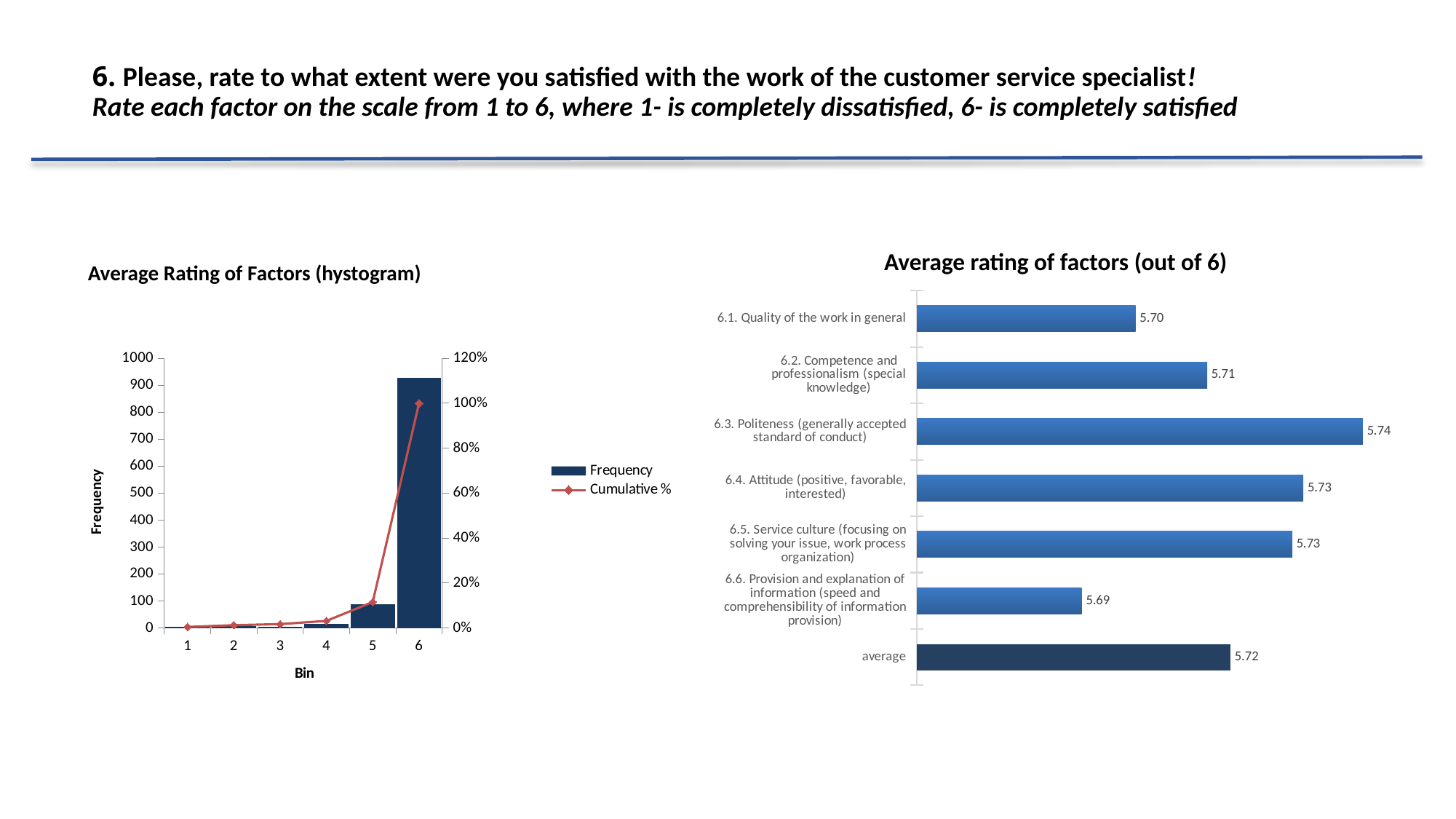
How many bars are shown in the 'Average rating of factors (out of 6)' chart? 7 In the 'Average rating of factors (out of 6)' chart, which factor has the highest rating? 6.3. Politeness (generally accepted standard of conduct) In the 'Average Rating of Factors (hystogram)' chart, what is the Cumulative % at bin 6? 100% In the 'Average Rating of Factors (hystogram)' chart, how many series does the legend list? 2 In the 'Average rating of factors (out of 6)' chart, what is the difference between the rating for 6.3. Politeness and the rating for 6.6. Provision and explanation of information? 0.05 In the 'Average rating of factors (out of 6)' chart, what is the value for 6.6. Provision and explanation of information? 5.69 What kind of chart is the 'Average rating of factors (out of 6)' chart? Bar chart In the 'Average Rating of Factors (hystogram)' chart, is the Frequency for bin 6 greater or less than 800? greater In the 'Average rating of factors (out of 6)' chart, which is larger: the rating for 6.1. Quality of the work in general or for 6.2. Competence and professionalism? 6.2. Competence and professionalism In the 'Average rating of factors (out of 6)' chart, what is the value for 'average'? 5.72 In the 'Average rating of factors (out of 6)' chart, what is the value for 6.3. Politeness (generally accepted standard of conduct)? 5.74 In the 'Average rating of factors (out of 6)' chart, which factor has the lowest rating? 6.6. Provision and explanation of information (speed and comprehensibility of information provision)